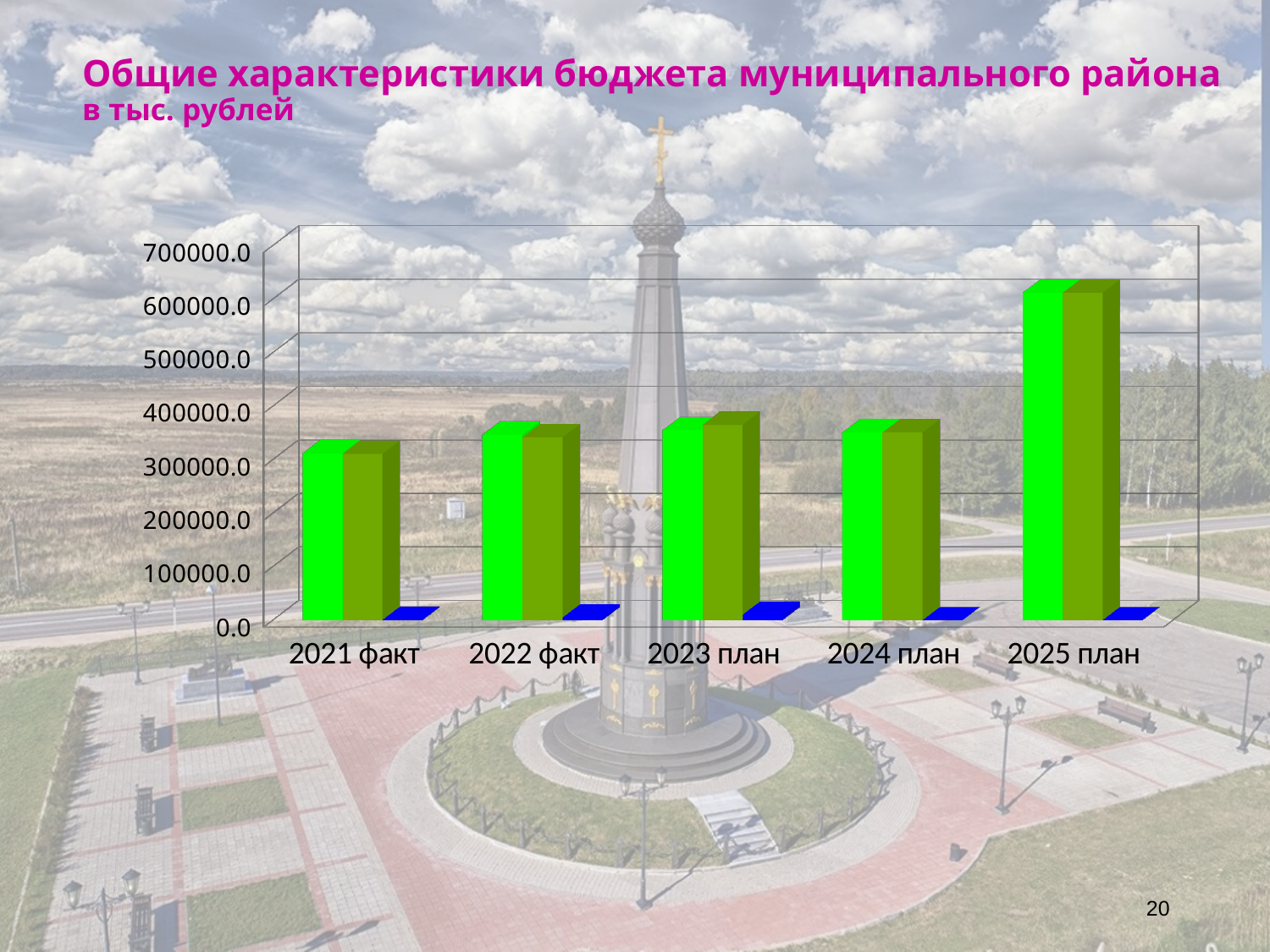
Is the green bar for 2025 план greater or less than 500000.0? greater Which category has the shortest green bar? 2021 факт Which green bar is taller: 2025 план or 2021 факт? 2025 план What is the highest value shown on the vertical axis of the chart? 700000.0 What is the title of the slide containing the chart? Общие характеристики бюджета муниципального района Is the green bar for 2022 факт greater or less than 200000.0? greater How many categories are shown on the x axis of the chart? 5 Which category has the tallest green bar? 2025 план Is the green bar for 2021 факт greater or less than 400000.0? less What kind of chart is shown on the slide? bar chart Which green bar is taller: 2023 план or 2021 факт? 2023 план